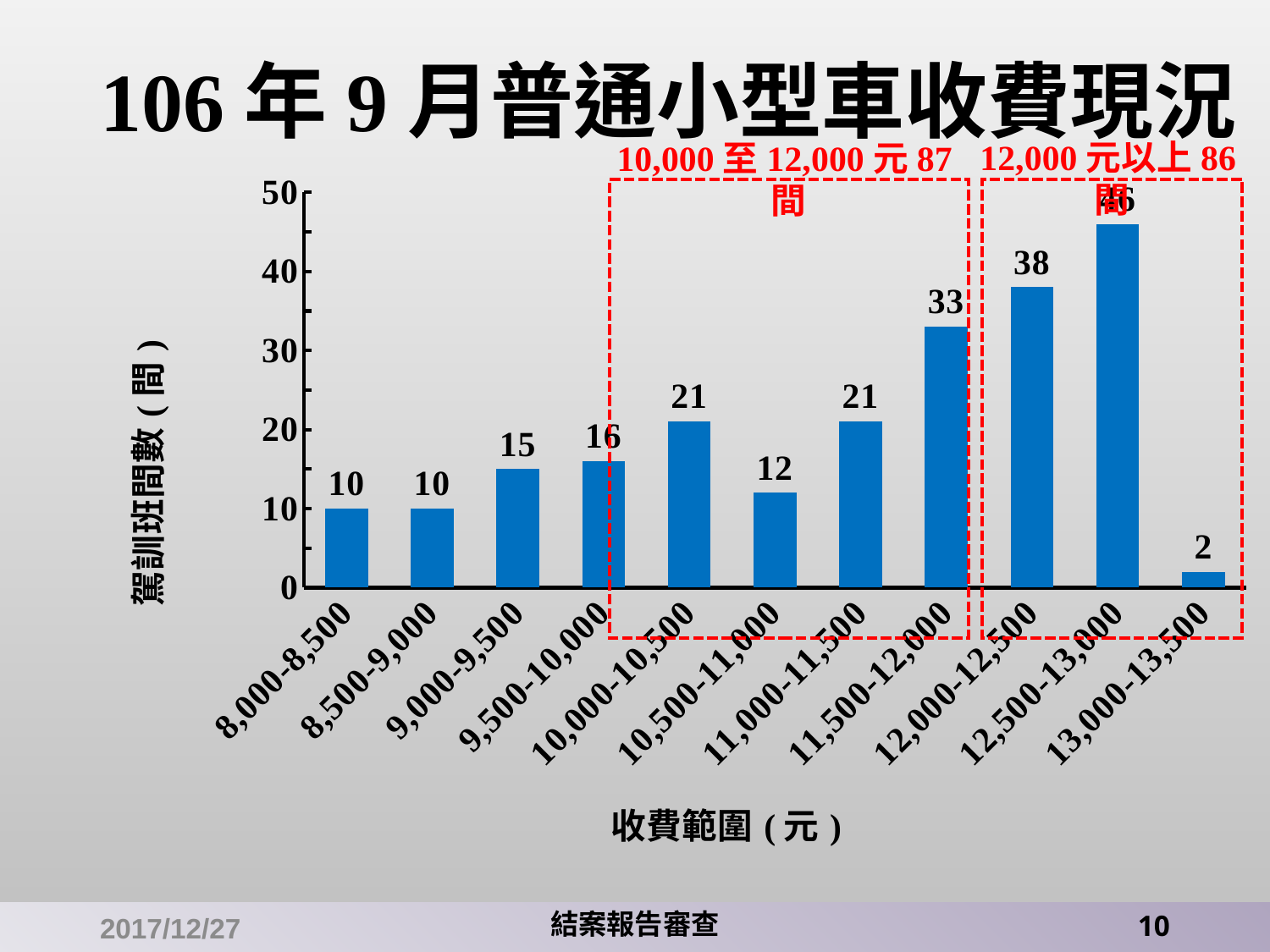
Is the value for 12,500-13,000 greater or less than 40? greater What is the value for the 8,000-8,500 category? 10 What is the difference between the values for 12,000-12,500 and 11,500-12,000? 5 How many fee-range categories are shown on the x axis? 11 Which fee-range category has the highest value? 12,500-13,000 What is the value for the 12,000-12,500 category? 38 Which is larger, the value for 10,000-10,500 or the value for 10,500-11,000? 10,000-10,500 Which fee-range category has the lowest value? 13,000-13,500 What type of chart is shown on the slide? bar chart What is the value for the 11,500-12,000 category? 33 What is the value for the 13,000-13,500 category? 2 What is the label of the y axis? 駕訓班間數（間）